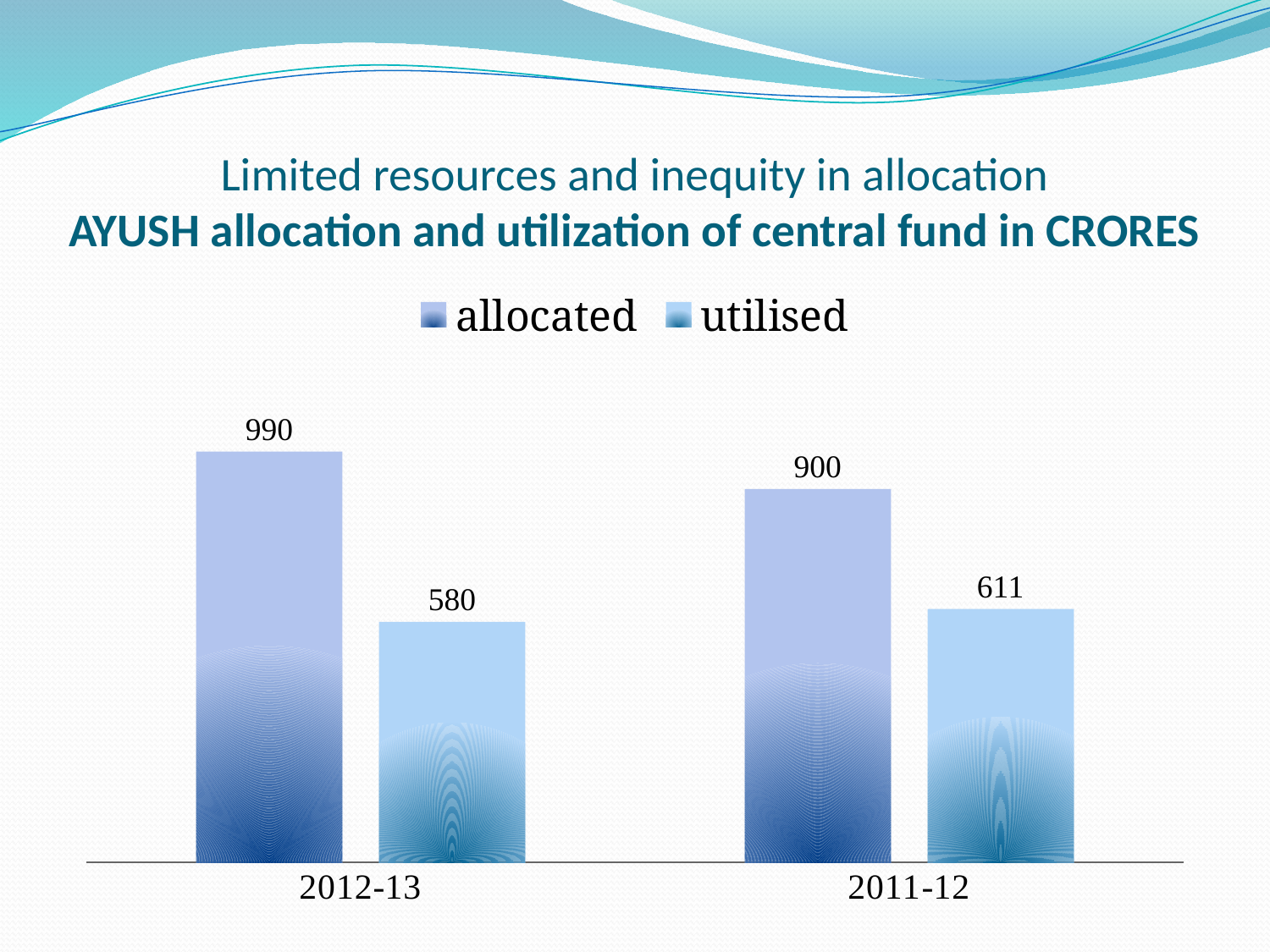
What was the allocated amount for 2011-12? 900 What was the utilised amount for 2011-12? 611 What kind of chart is shown on the slide? Bar chart Which year had the lower utilised amount? 2012-13 How many series does the legend list? 2 Which year had the higher allocated amount? 2012-13 How many years are shown on the x axis? 2 What is the difference between the allocated and utilised amounts in 2011-12? 289 What was the utilised amount for 2012-13? 580 Was the utilised amount higher in 2011-12 or 2012-13? 2011-12 What was the allocated amount for 2012-13? 990 What is the difference between the allocated and utilised amounts in 2012-13? 410